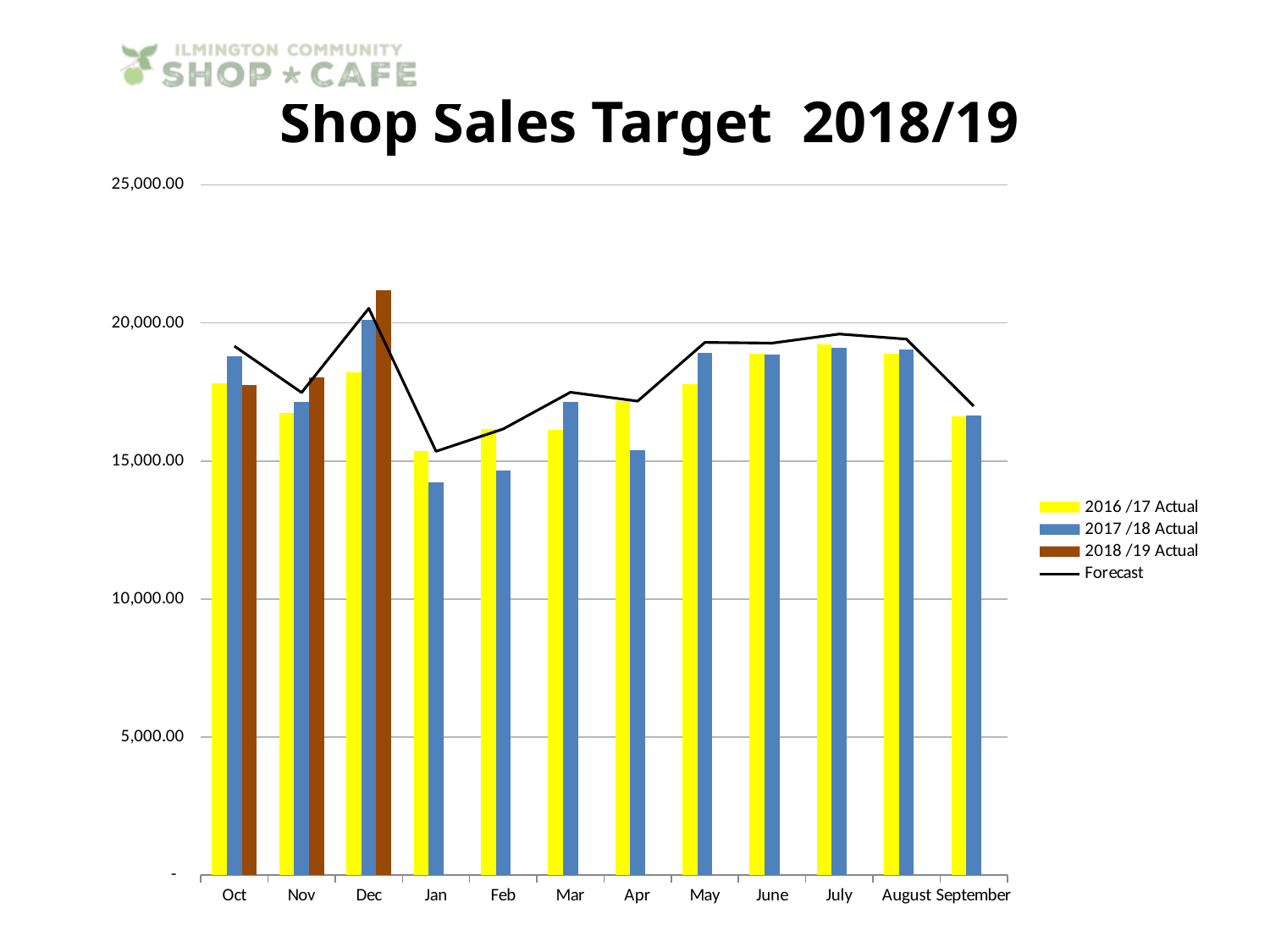
What is the title of the chart? Shop Sales Target 2018/19 Is the 2018 /19 Actual value for Dec greater or less than 20,000.00? greater Is the 2017 /18 Actual value for Jan greater or less than 15,000.00? less How many series does the legend list? 4 How many months are shown on the x axis? 12 Which month has the highest 2018 /19 Actual bar? Dec For how many months is a 2018 /19 Actual bar plotted? 3 What kind of chart is shown on the slide? Bar chart with a line Which month has the lowest 2016 /17 Actual bar? Jan In Oct, which is larger: the 2016 /17 Actual bar or the 2017 /18 Actual bar? 2017 /18 Actual Which month has the highest 2017 /18 Actual bar? Dec Which series is drawn as a line rather than bars? Forecast